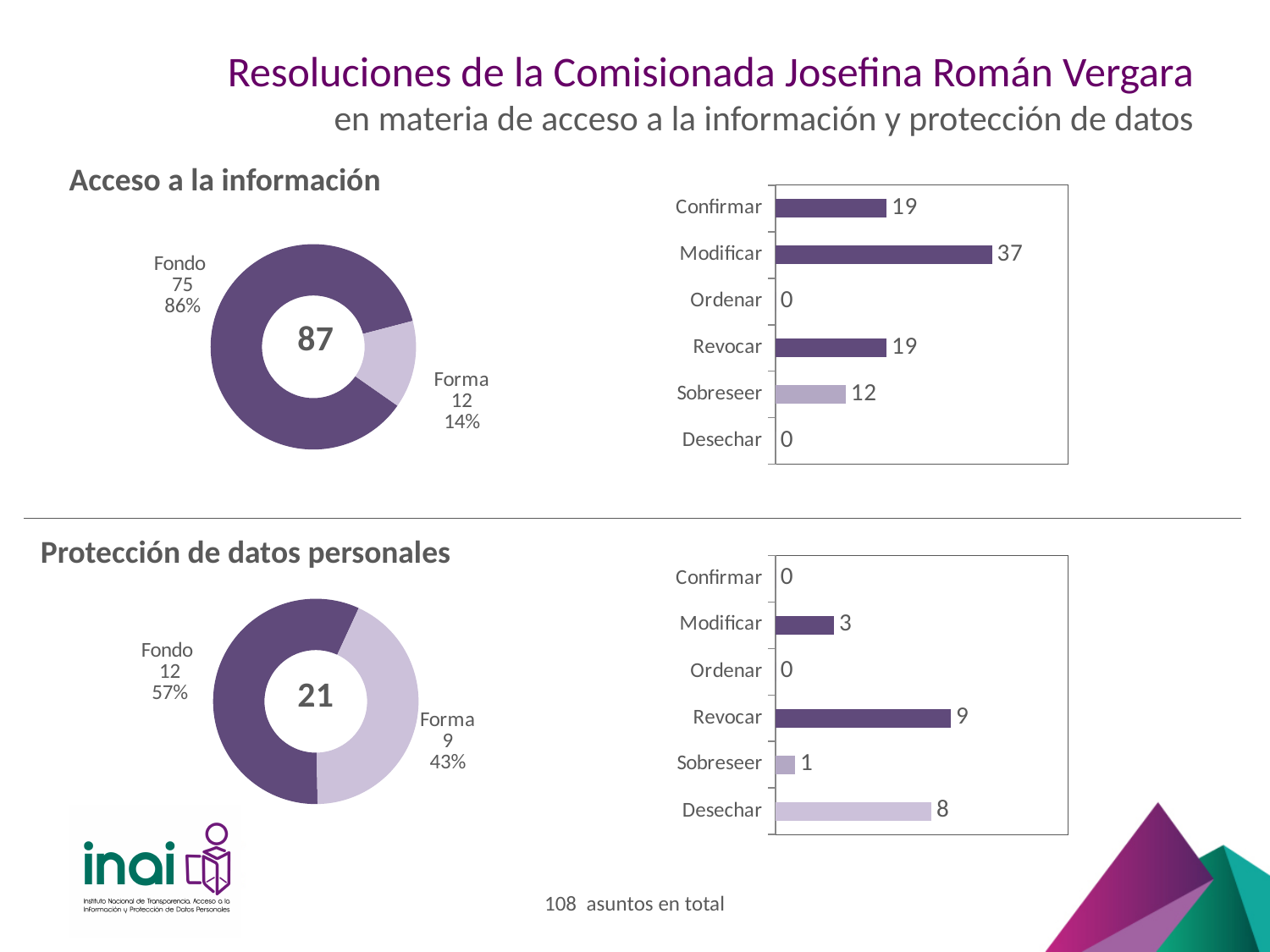
In the 'Acceso a la información' donut chart, what value is shown for Fondo? 75 In the 'Protección de datos personales' donut chart, what percentage share does Fondo have? 57% In the top-right bar chart (Acceso a la información), what is the value for Modificar? 37 What kind of chart is the top-right chart showing Confirmar, Modificar, Ordenar, Revocar, Sobreseer and Desechar? Bar chart In the bottom-right bar chart (Protección de datos personales), which category has the highest value? Revocar In the bottom-right bar chart (Protección de datos personales), which is larger, Desechar or Modificar? Desechar In the top-right bar chart (Acceso a la información), which category has the highest value? Modificar How many categories are shown in the top-right bar chart (Acceso a la información)? 6 What total is shown in the centre of the 'Acceso a la información' donut chart? 87 In the 'Protección de datos personales' donut chart, what value is shown for Forma? 9 In the top-right bar chart (Acceso a la información), what is the difference between Modificar and Confirmar? 18 In the 'Acceso a la información' donut chart, what percentage share does Forma have? 14%